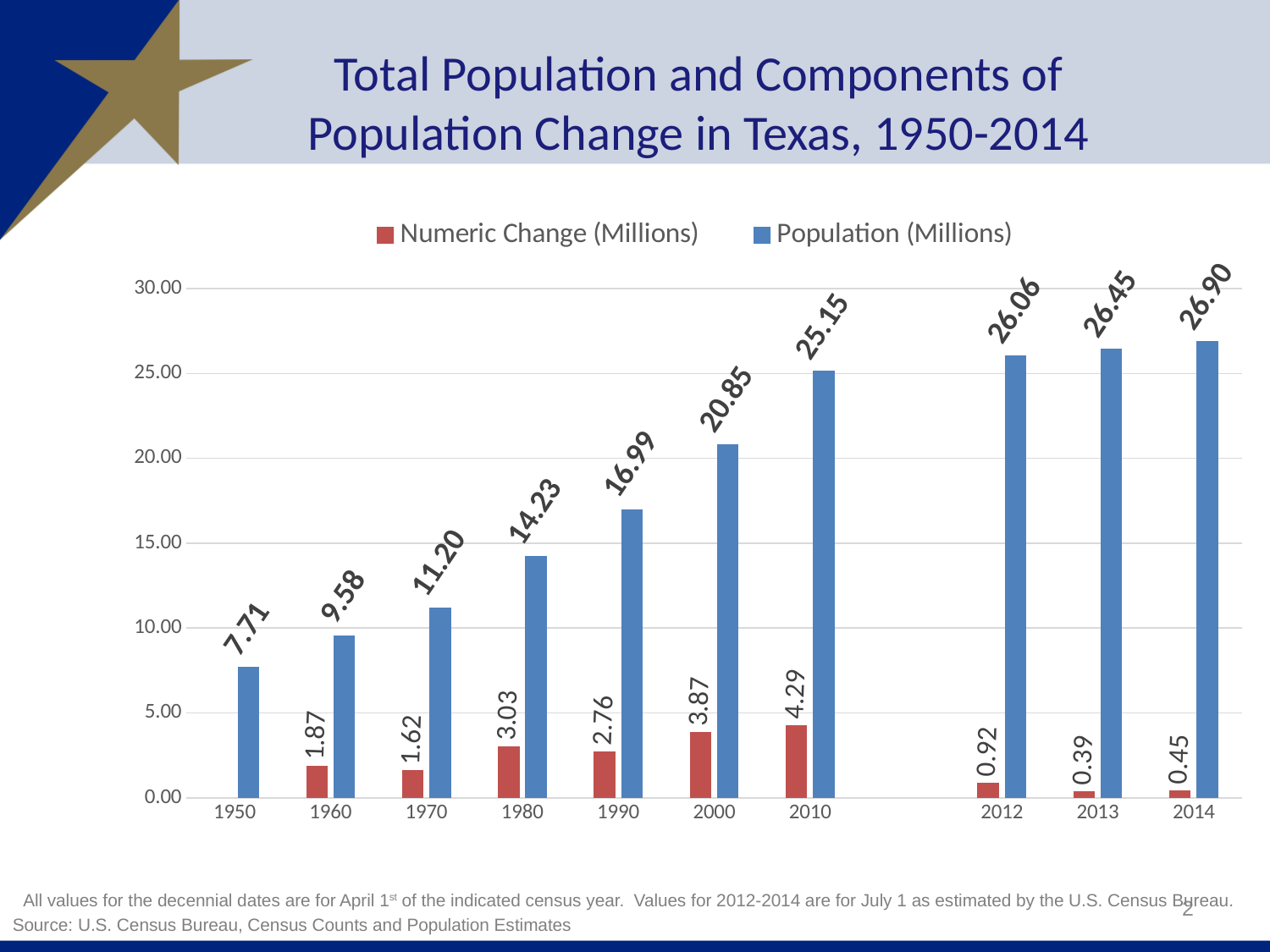
Which year has the lowest Numeric Change (Millions) value? 2013 What is the difference between the Population (Millions) values for 2014 and 2010? 1.75 How many series does the legend list? 2 What is the Numeric Change (Millions) value for 1980? 3.03 What is the Population (Millions) value for 1950? 7.71 Which year has the highest Population (Millions) value? 2014 What is the Population (Millions) value for 2010? 25.15 How many years are shown on the x axis? 10 Which is larger, the Numeric Change (Millions) for 1990 or for 2000? 2000 What kind of chart is shown on the slide? Bar chart Which year has the highest Numeric Change (Millions) value? 2010 Does the Population (Millions) series rise or fall from 1950 to 2014? Rise